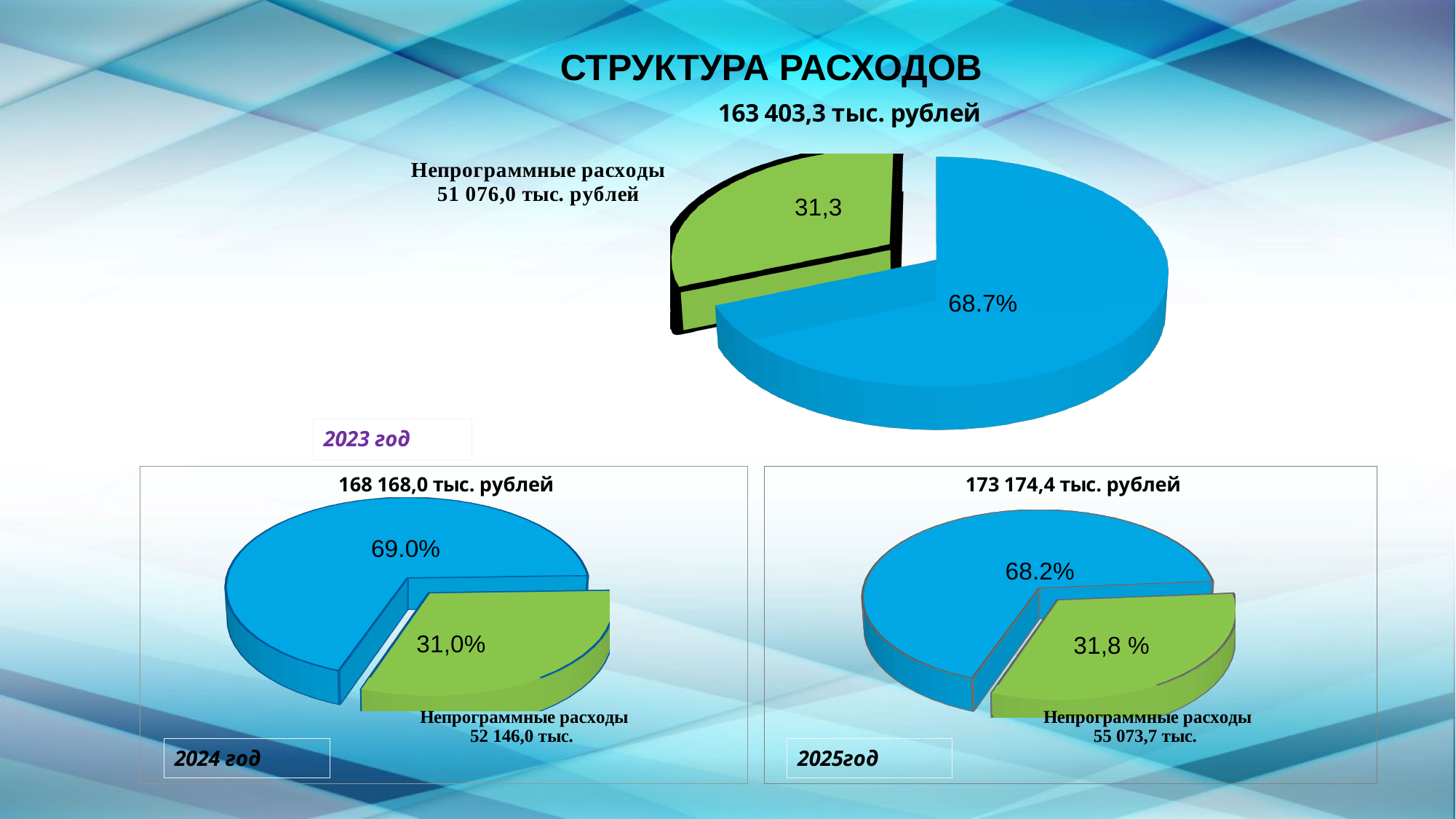
What amount is given for Непрограммные расходы in the 2025год chart? 55 073,7 тыс. In the 2023 год pie chart, what percentage is shown on the blue slice? 68.7% What kind of chart is used for the 2023 год data on the slide? pie chart In the 2023 год pie chart, what value is shown on the green slice (Непрограммные расходы)? 31,3 In the 2024 год pie chart, what percentage is shown for Непрограммные расходы? 31,0% In the 2025год pie chart, what percentage is shown on the green slice (Непрограммные расходы)? 31,8 % In the 2023 год chart, what amount is given for Непрограммные расходы? 51 076,0 тыс. рублей In the 2024 год pie chart, what percentage is shown on the blue slice? 69.0% What total amount is shown above the 2024 год pie chart? 168 168,0 тыс. рублей What total amount is shown above the 2023 год pie chart? 163 403,3 тыс. рублей In the 2025год pie chart, which slice is larger, the blue one or the green one? the blue one How many slices does the 2024 год pie chart have? 2